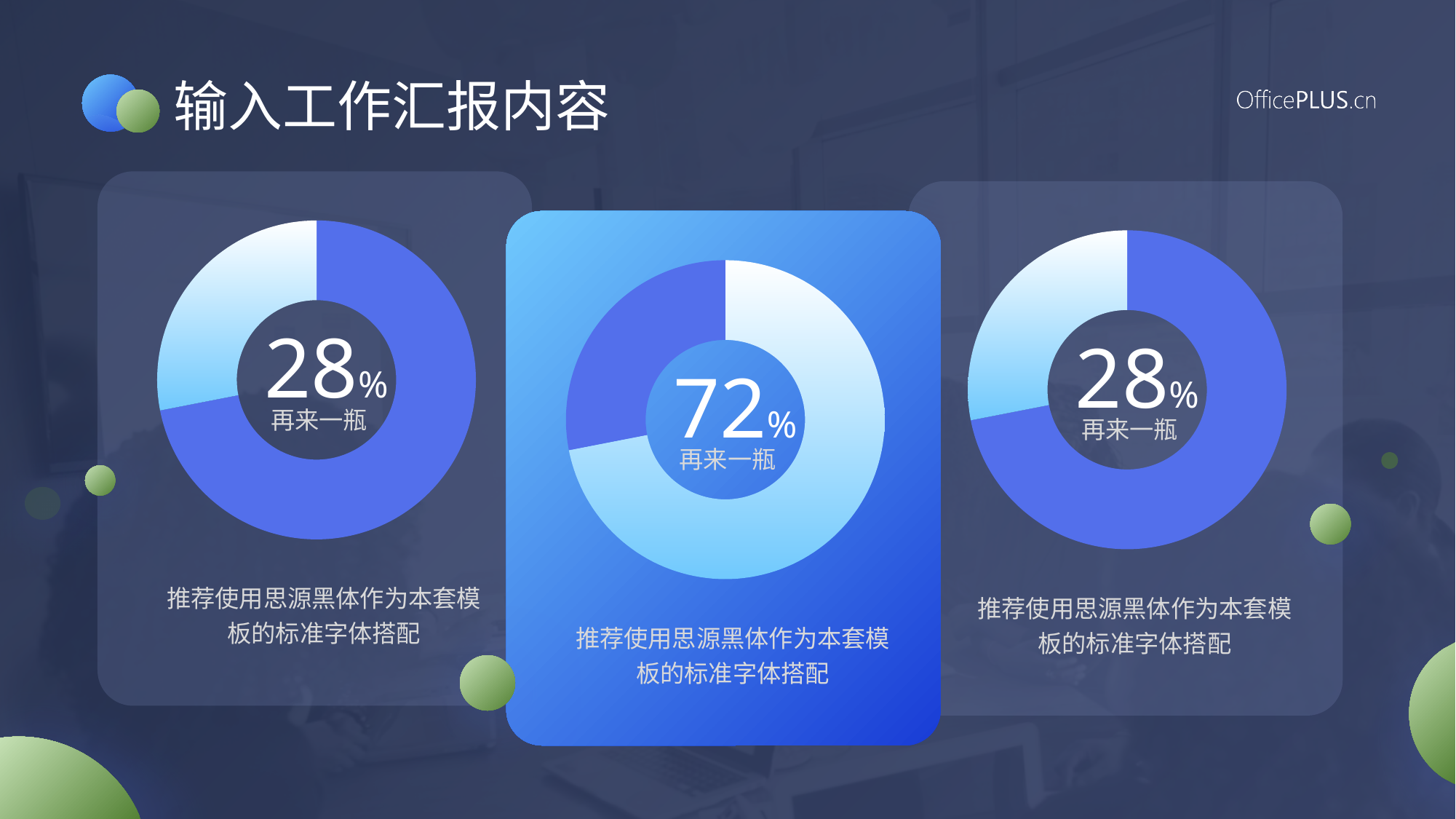
How many donut charts are on the slide? 3 What percentage is printed in the centre of the right donut chart? 28% What text label appears directly below the percentage in the middle donut chart? 再来一瓶 Is the value shown in the left donut chart greater or less than 50%? less What kind of chart is shown in the left panel of the slide? Donut chart How many segments does each donut chart have? 2 Is the percentage in the middle donut chart larger or smaller than the percentage in the left donut chart? Larger What is the difference between the percentage in the middle donut chart and the percentage in the right donut chart? 44% What percentage is printed in the centre of the left donut chart? 28% Which donut chart shows the highest percentage value? The middle chart (72%) Is the value shown in the middle donut chart greater or less than 50%? greater What percentage is printed in the centre of the middle donut chart? 72%